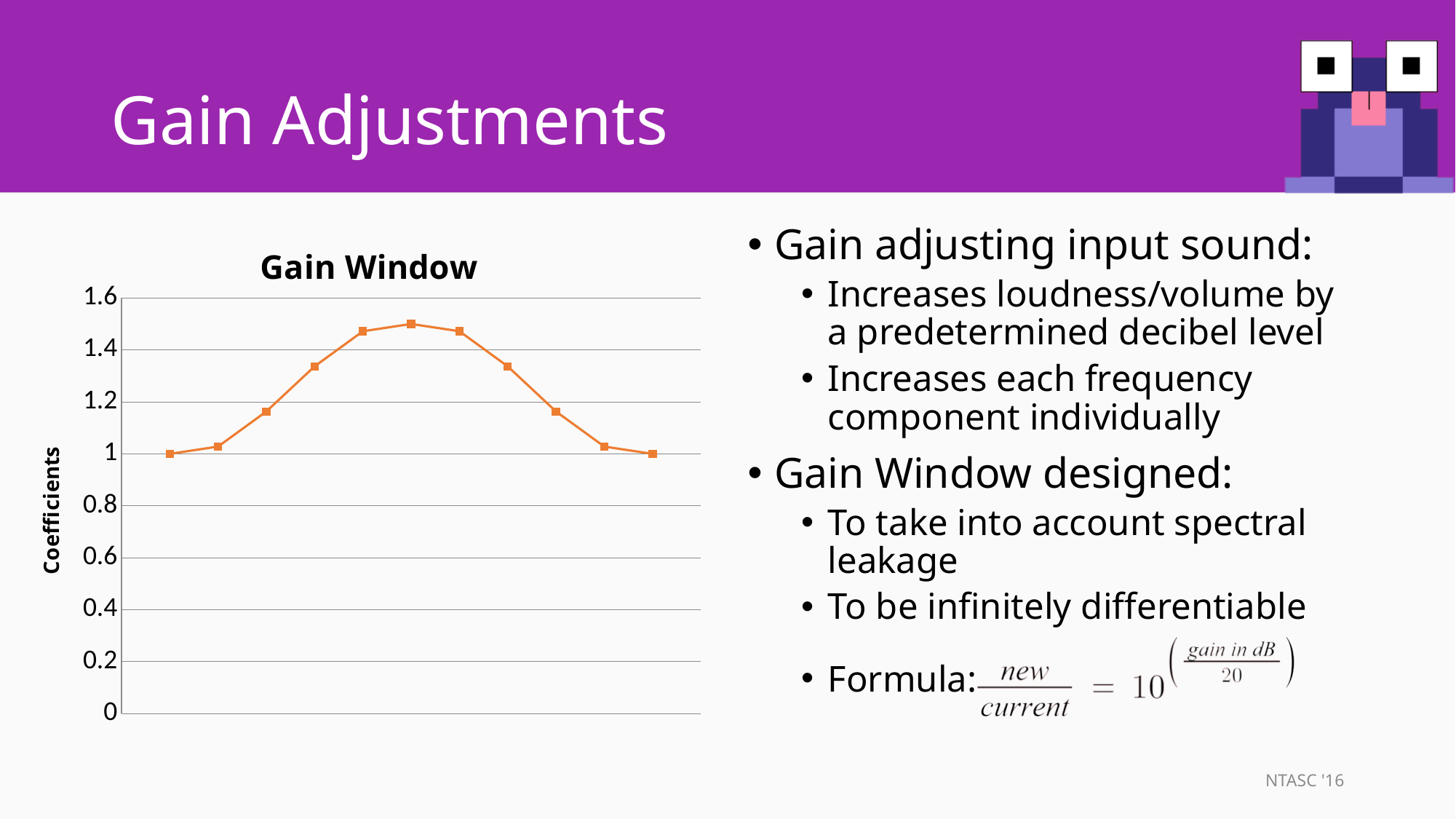
Is the value of the highest point on the line greater or less than 1.4? greater Is the value of the highest point on the line greater or less than 1.6? less What is the label on the vertical axis of the chart? Coefficients Which point on the line has the highest value: the middle (sixth) point or the first point? the middle (sixth) point Do the values rise or fall from the leftmost point to the middle point of the line? rise How many data points are plotted on the line? 11 Is the value of the fourth point from the left greater or less than 1.2? greater What is the title of the chart? Gain Window What is the value of the last (rightmost) point on the line? 1 What is the value of the first (leftmost) point on the line? 1 What kind of chart is shown on the slide? line chart